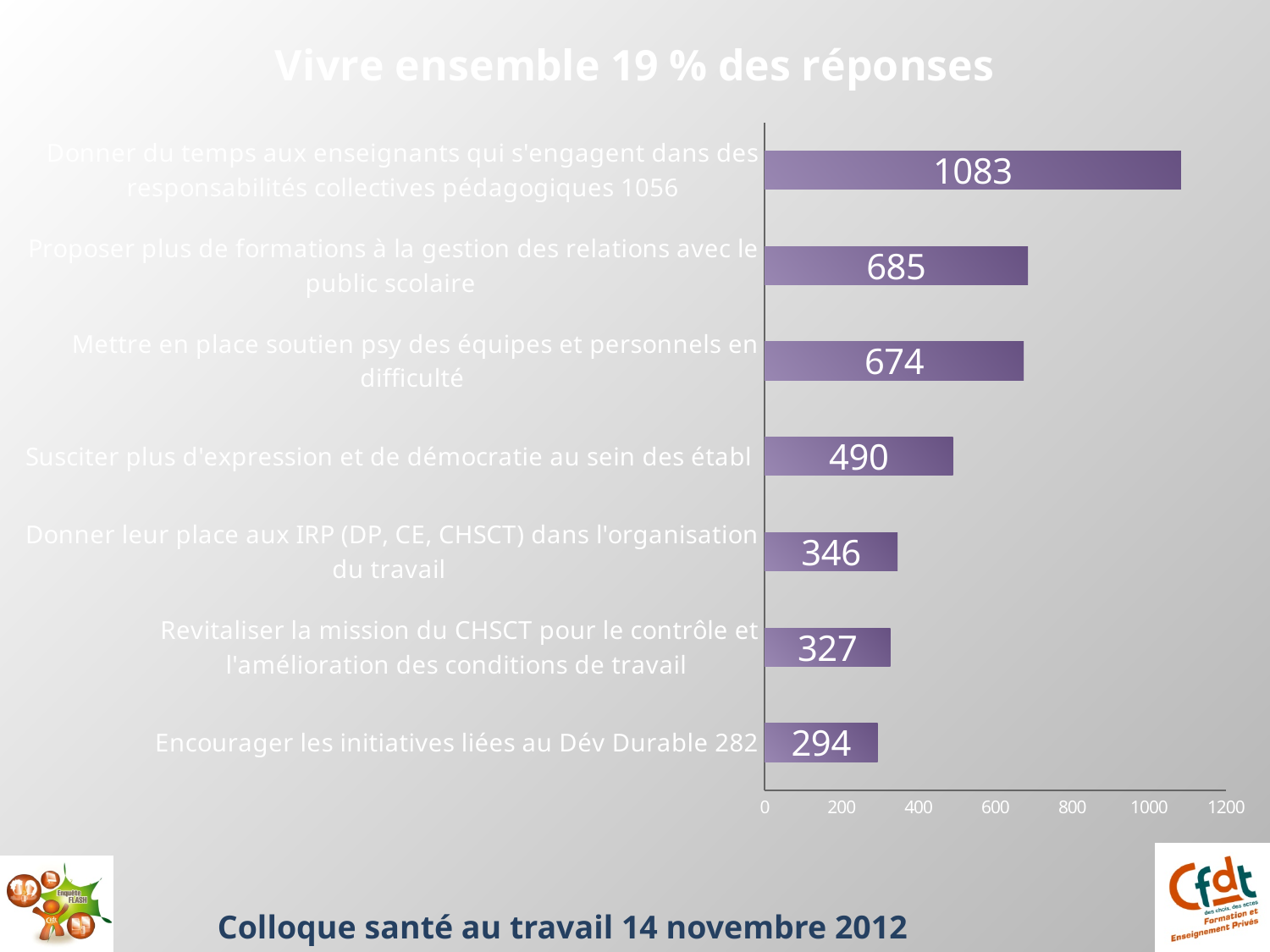
How many categories are plotted in the chart? 7 What is the value for "Susciter plus d'expression et de démocratie au sein des établ"? 490 Which category has the lowest value? Encourager les initiatives liées au Dév Durable 282 What is the maximum value shown on the horizontal axis? 1200 What type of chart is shown on the slide? bar chart What is the difference between the values for "Mettre en place soutien psy des équipes et personnels en difficulté" and "Donner leur place aux IRP (DP, CE, CHSCT) dans l'organisation du travail"? 328 Is the value for "Donner du temps aux enseignants qui s'engagent dans des responsabilités collectives pédagogiques 1056" greater or less than 1000? greater Which category has the highest value? Donner du temps aux enseignants qui s'engagent dans des responsabilités collectives pédagogiques 1056 What is the value for "Proposer plus de formations à la gestion des relations avec le public scolaire"? 685 What is the value for "Revitaliser la mission du CHSCT pour le contrôle et l'amélioration des conditions de travail"? 327 What is the chart's title? Vivre ensemble 19 % des réponses Which is larger: the value for "Donner leur place aux IRP (DP, CE, CHSCT) dans l'organisation du travail" or the value for "Encourager les initiatives liées au Dév Durable 282"? Donner leur place aux IRP (DP, CE, CHSCT) dans l'organisation du travail